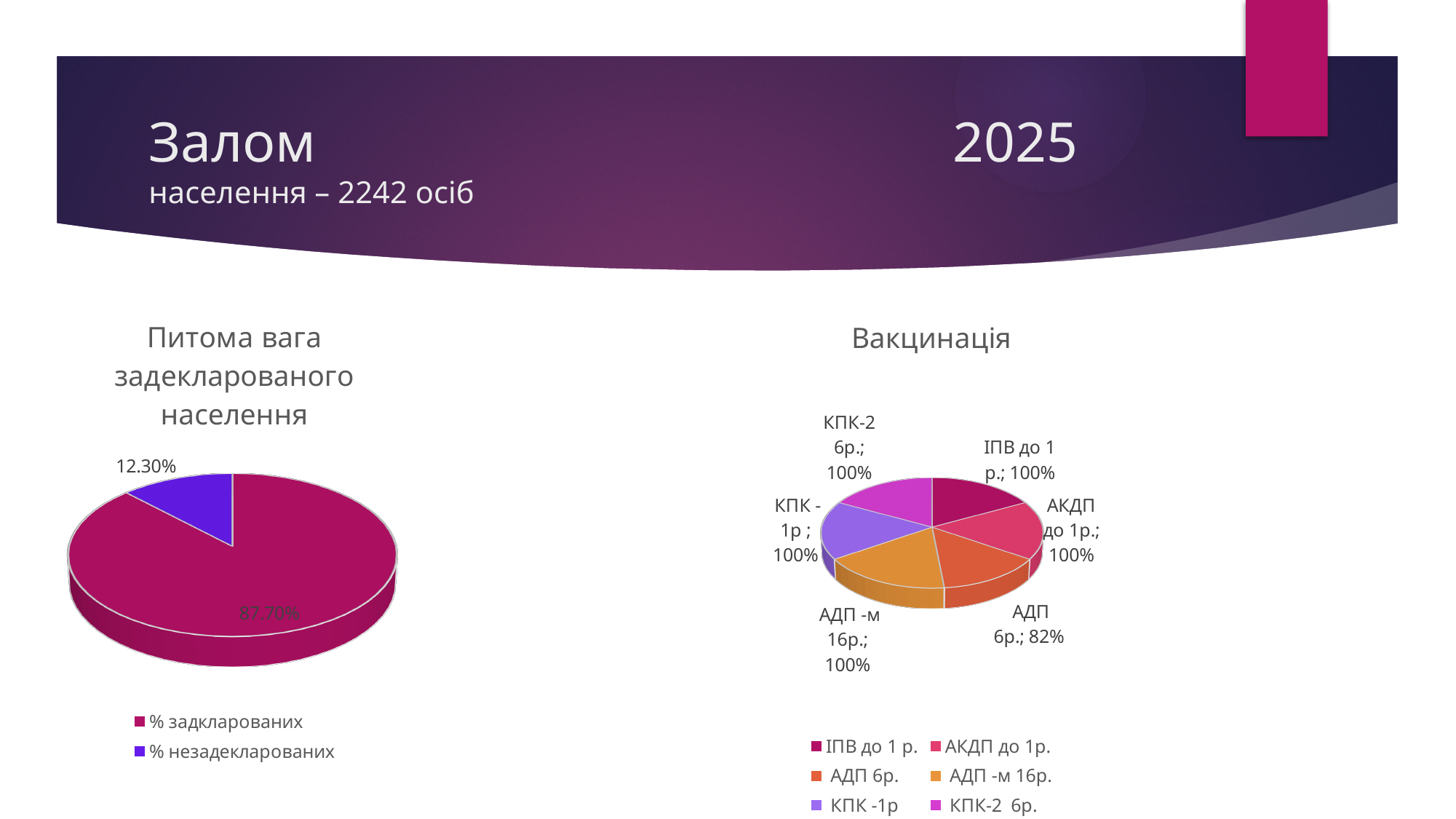
In the chart titled "Вакцинація", what is the value for "АДП 6р."? 82% In the chart titled "Вакцинація", is the value for "ІПВ до 1 р." larger or smaller than the value for "АДП 6р."? larger In the chart titled "Питома вага задекларованого населення", what is the value for "% незадекларованих"? 12.30% What kind of chart is the chart titled "Вакцинація"? Pie chart In the chart titled "Питома вага задекларованого населення", which category has the larger share? % задкларованих In the chart titled "Питома вага задекларованого населення", how many categories does the legend list? 2 In the chart titled "Вакцинація", what is the value for "КПК-2 6р."? 100% In the chart titled "Питома вага задекларованого населення", what is the value for "% задкларованих"? 87.70% In the chart titled "Вакцинація", how many categories are plotted? 6 In the chart titled "Вакцинація", what is the difference between the values for "АКДП до 1р." and "АДП 6р."? 18% In the chart titled "Питома вага задекларованого населення", what is the difference between the two values? 75.40% In the chart titled "Вакцинація", which category has the lowest value? АДП 6р.